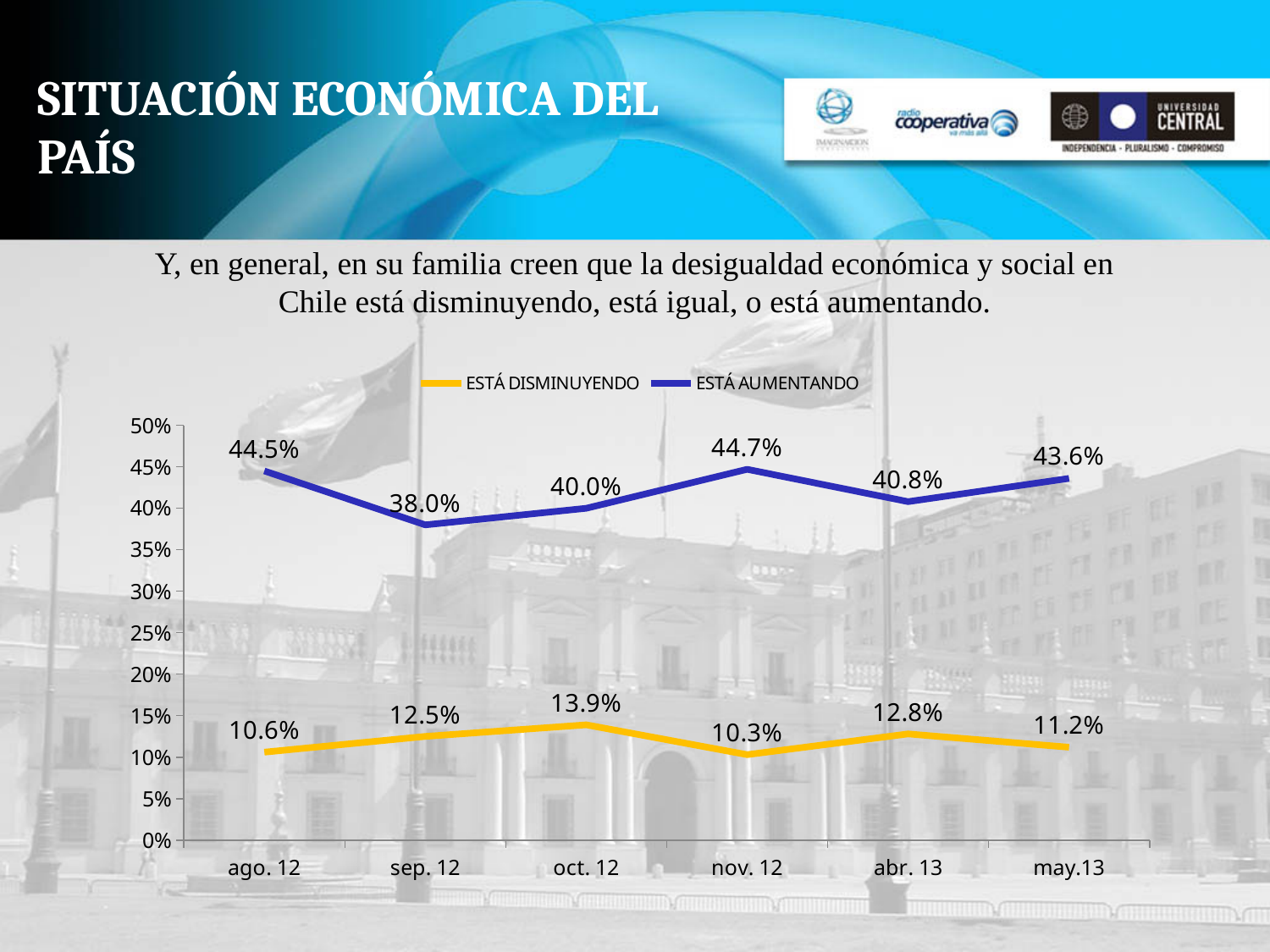
In which period is ESTÁ DISMINUYENDO lowest? nov. 12 What kind of chart is shown on the slide? Line chart Which colour is used for the ESTÁ DISMINUYENDO series? Yellow How many periods are shown on the x axis? 6 In which period is ESTÁ AUMENTANDO highest? nov. 12 Which is larger for ESTÁ DISMINUYENDO: sep. 12 or abr. 13? abr. 13 What is the value for ESTÁ DISMINUYENDO in oct. 12? 13.9% What is the value for ESTÁ AUMENTANDO in sep. 12? 38.0% How many series does the legend list? 2 What is the value for ESTÁ AUMENTANDO in nov. 12? 44.7% Is the value for ESTÁ AUMENTANDO in abr. 13 greater or less than 35%? greater What is the difference between ESTÁ AUMENTANDO and ESTÁ DISMINUYENDO in may.13? 32.4%